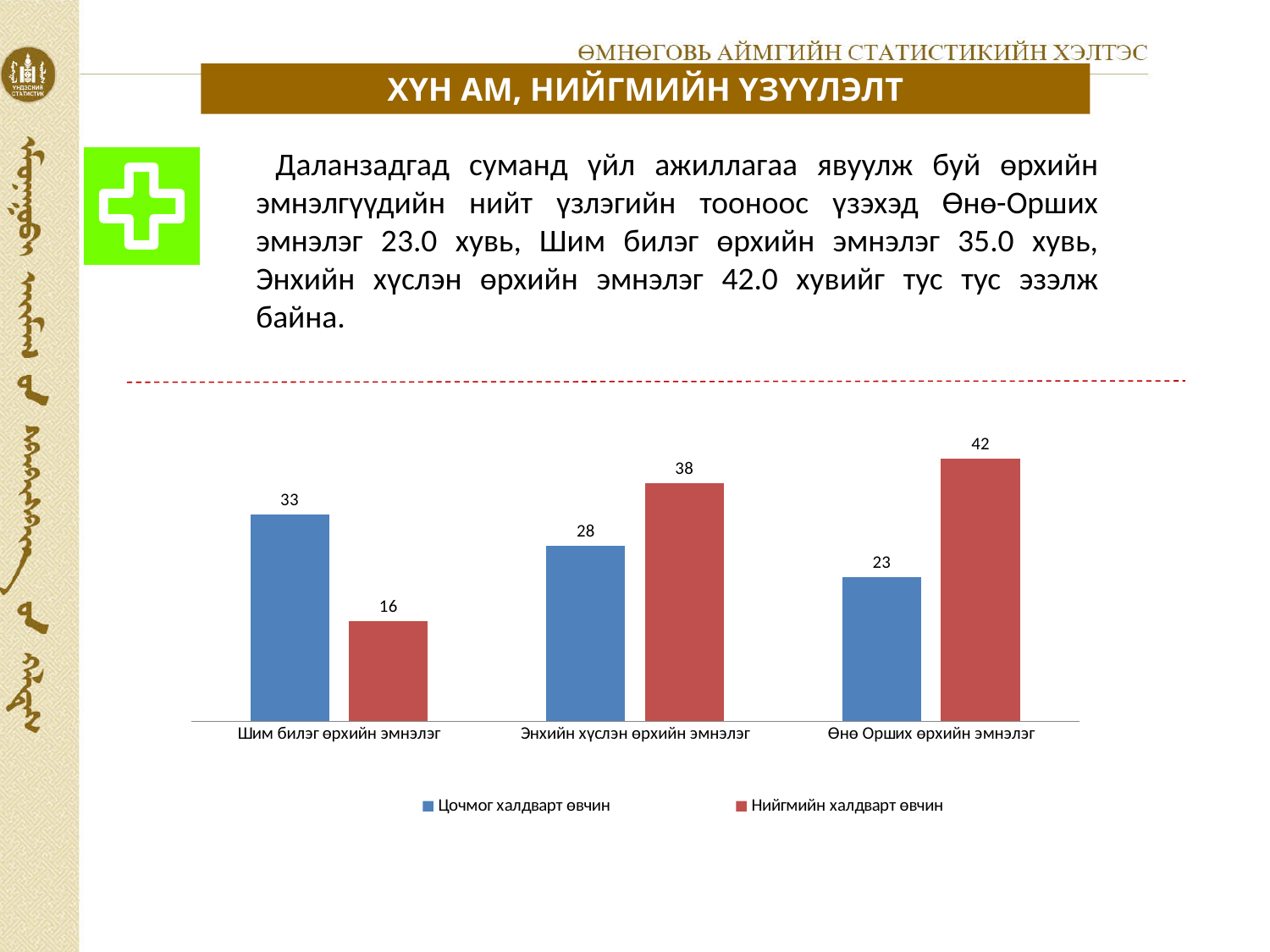
Which category has the highest value for Нийгмийн халдварт өвчин? Өнө Орших өрхийн эмнэлэг What is the value for Цочмог халдварт өвчин at Энхийн хүслэн өрхийн эмнэлэг? 28 What is the value for Нийгмийн халдварт өвчин at Өнө Орших өрхийн эмнэлэг? 42 What is the difference between the Нийгмийн халдварт өвчин values for Өнө Орших өрхийн эмнэлэг and Шим билэг өрхийн эмнэлэг? 26 What is the value for Нийгмийн халдварт өвчин at Шим билэг өрхийн эмнэлэг? 16 How many series does the chart legend list? 2 At Энхийн хүслэн өрхийн эмнэлэг, which series has the larger value, Цочмог халдварт өвчин or Нийгмийн халдварт өвчин? Нийгмийн халдварт өвчин How many categories are shown on the x axis of the chart? 3 What colour are the bars for Нийгмийн халдварт өвчин? Red What is the value for Цочмог халдварт өвчин at Шим билэг өрхийн эмнэлэг? 33 Which category has the lowest value for Цочмог халдварт өвчин? Өнө Орших өрхийн эмнэлэг What kind of chart is shown on the slide? Bar chart